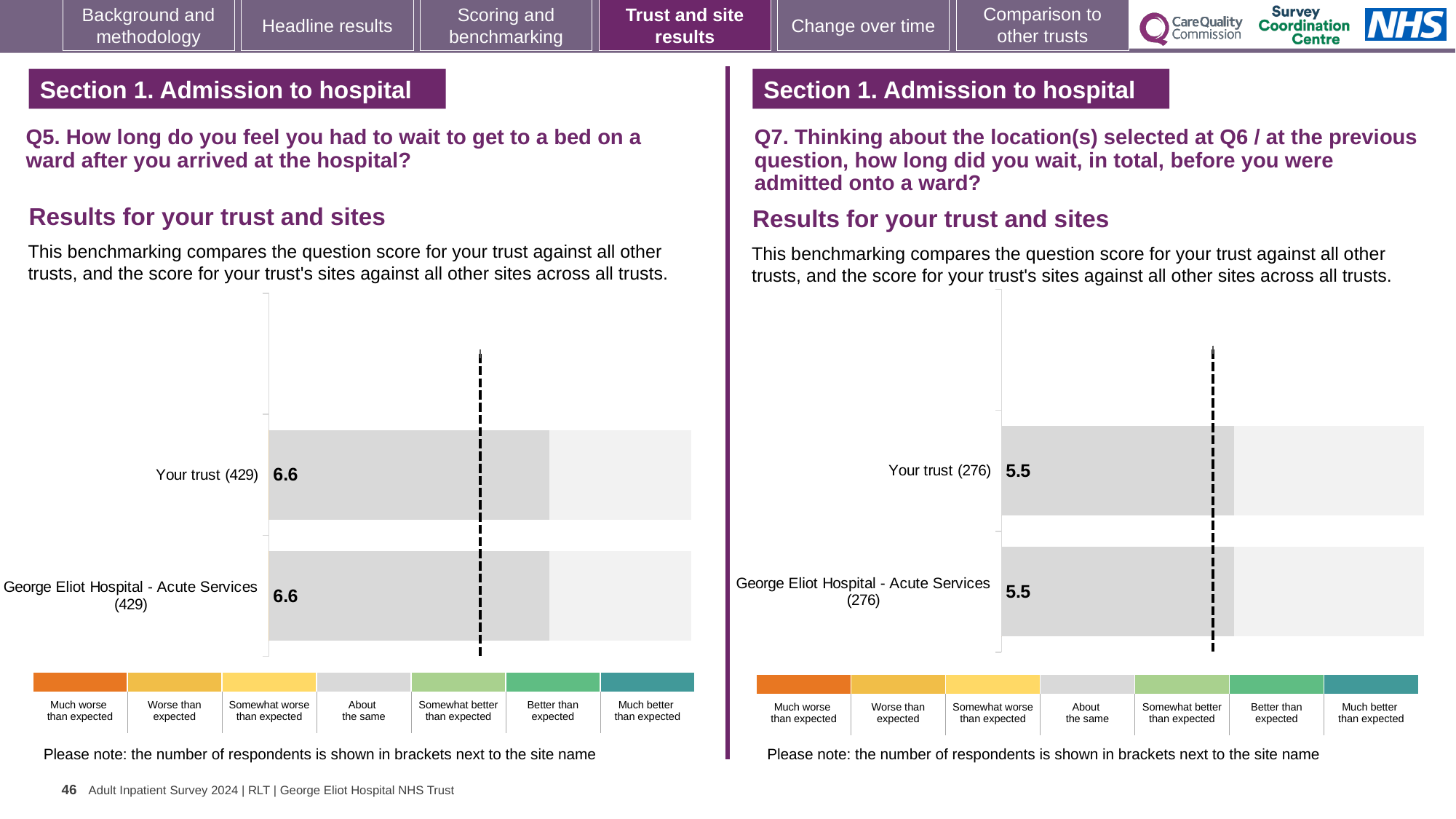
In the Q5 chart on the left, what is the score for George Eliot Hospital - Acute Services? 6.6 In the Q5 chart on the left, how many bars are plotted? 2 In the Q5 chart on the left, what is the score for Your trust? 6.6 In the Q7 chart on the right, how many bars are plotted? 2 In the Q5 chart on the left, what is the difference between the score for Your trust and the score for George Eliot Hospital - Acute Services? 0 In the Q7 chart on the right, what is the score for Your trust? 5.5 Which is larger: the Your trust score in the Q5 chart on the left or the Your trust score in the Q7 chart on the right? Q5 chart (6.6) In the Q7 chart on the right, how many respondents are shown in brackets next to George Eliot Hospital - Acute Services? 276 In the Q5 chart on the left, how many respondents are shown in brackets next to Your trust? 429 In the Q7 chart on the right, is the score for Your trust greater or less than 6? less In the Q7 chart on the right, what is the score for George Eliot Hospital - Acute Services? 5.5 What kind of chart is the Q5 chart on the left? Bar chart